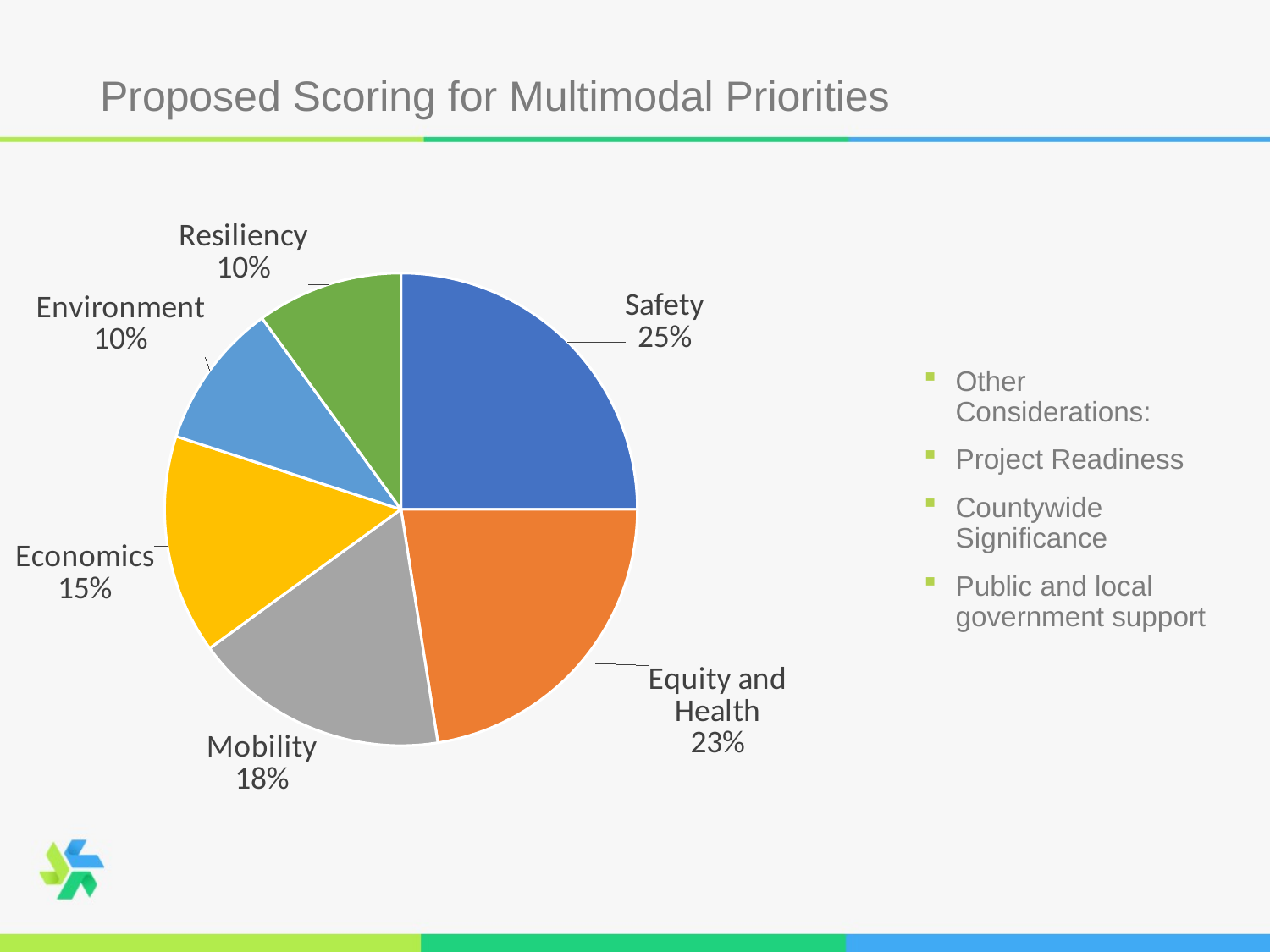
What is the difference between the Safety and Mobility percentages? 7% What percentage is shown for Economics? 15% Which two categories share the smallest percentage of 10%? Resiliency and Environment What share of the pie does Safety have? 25% What kind of chart is shown on the slide? pie chart What percentage is shown for Mobility? 18% What percentage is shown for Equity and Health? 23% What colour is the Safety slice? blue Which category has the largest slice of the pie? Safety What is the difference between the Equity and Health and Economics percentages? 8% Which is larger, the Economics slice or the Environment slice? Economics How many categories are shown in the pie chart? 6